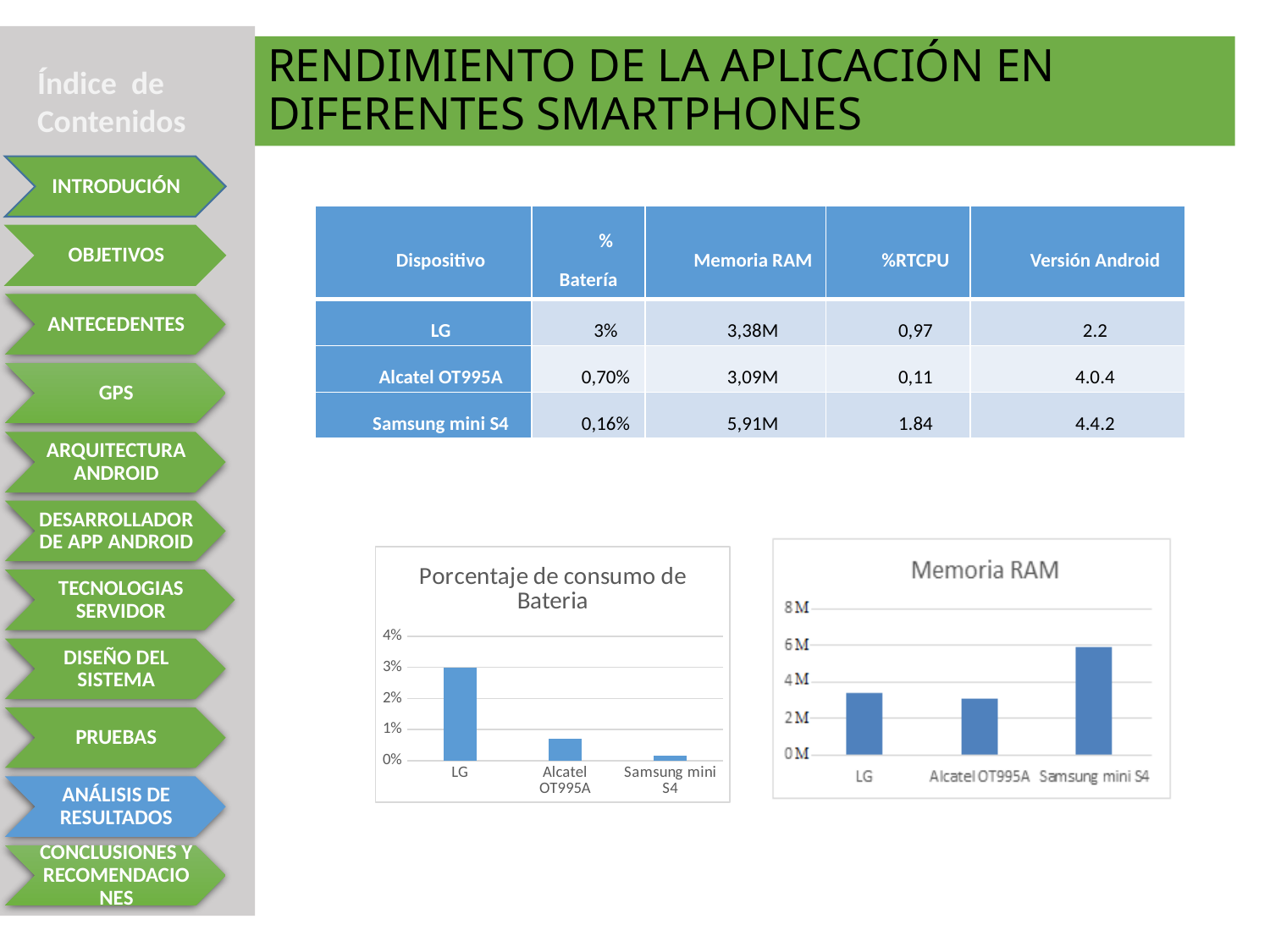
On the 'Porcentaje de consumo de Bateria' chart, which is larger, the value for LG or the value for Alcatel OT995A? LG On the 'Porcentaje de consumo de Bateria' chart, what is the value for LG? 3% On the 'Porcentaje de consumo de Bateria' chart, which device has the highest battery consumption? LG What kind of chart is the 'Memoria RAM' chart? Bar chart On the 'Porcentaje de consumo de Bateria' chart, which device has the lowest battery consumption? Samsung mini S4 On the 'Porcentaje de consumo de Bateria' chart, is the value for Alcatel OT995A greater or less than 1%? less On the 'Memoria RAM' chart, is the value for Alcatel OT995A greater or less than 4M? less On the 'Memoria RAM' chart, which device has the highest memory usage? Samsung mini S4 On the 'Porcentaje de consumo de Bateria' chart, how many devices are shown? 3 On the 'Memoria RAM' chart, is the value for Samsung mini S4 greater or less than 4M? greater On the 'Memoria RAM' chart, which is larger, the value for Samsung mini S4 or the value for LG? Samsung mini S4 What is the title of the chart on the left side of the slide? Porcentaje de consumo de Bateria